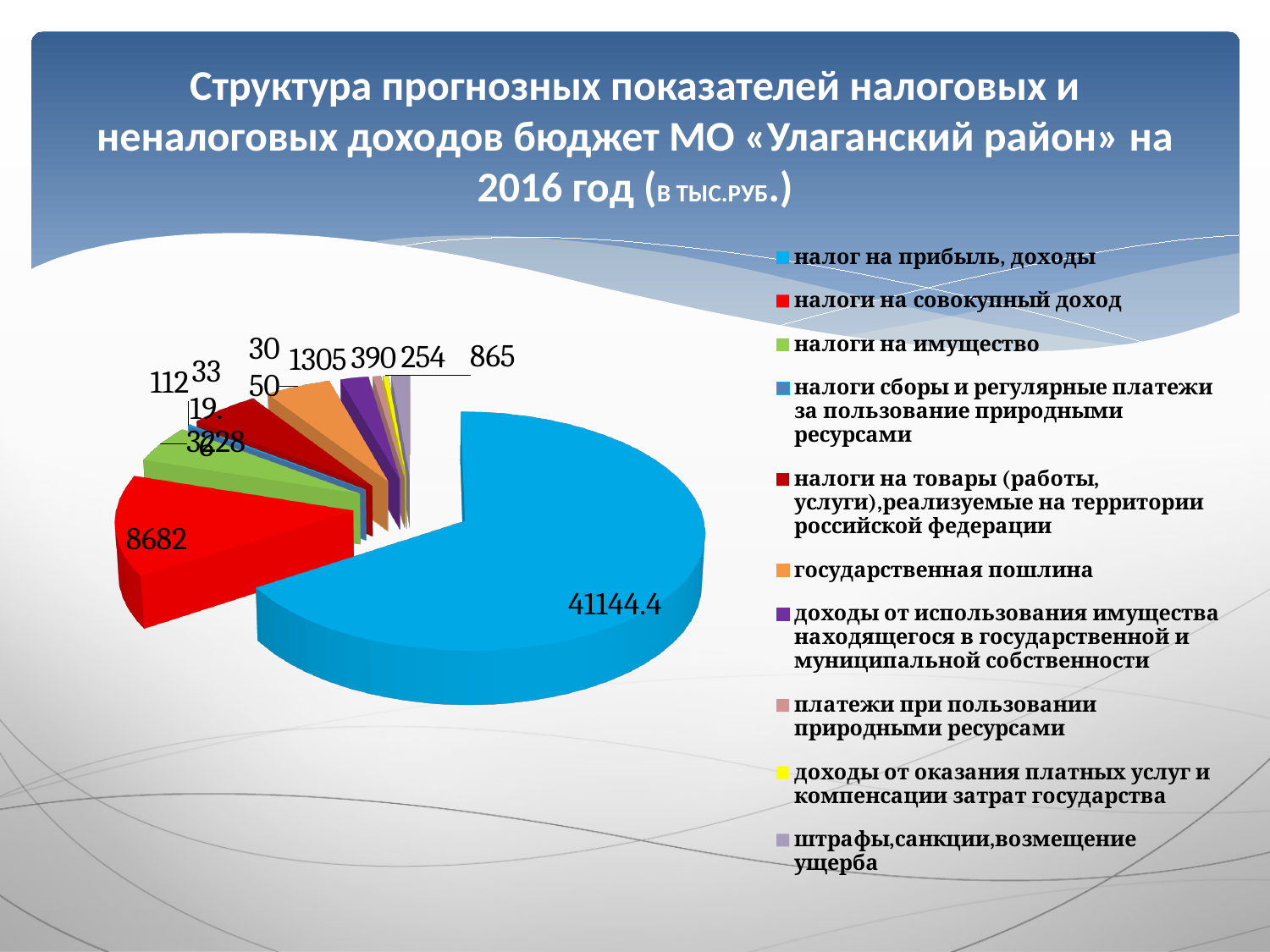
Which category has the largest slice of the pie? налог на прибыль, доходы What is the value shown for налоги на имущество? 3228 What colour is the slice for налог на прибыль, доходы? blue What is the difference between the values for налог на прибыль, доходы and налоги на совокупный доход? 32462.4 How many entries does the legend list? 10 In what units are the values on the chart given, according to the title? тыс.руб. What kind of chart is shown on the slide? pie chart What is the value shown for налоги на совокупный доход? 8682 What is the value shown for налог на прибыль, доходы? 41144.4 What is the difference between the values for налоги на совокупный доход and налоги на имущество? 5454 Which is larger, налоги на совокупный доход or налоги на имущество? налоги на совокупный доход Which is larger, налог на прибыль, доходы or налоги на совокупный доход? налог на прибыль, доходы